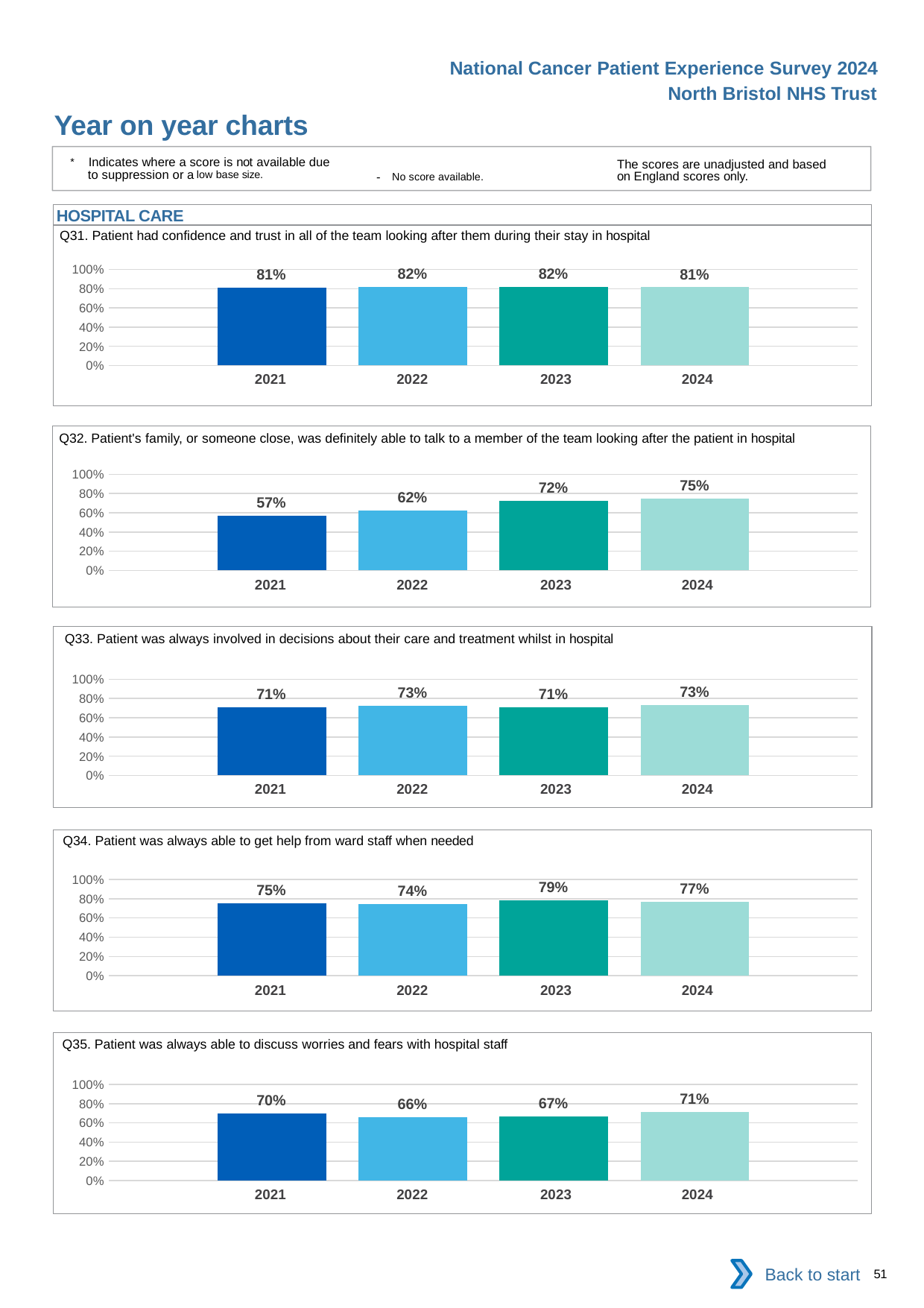
In the Q32 chart (patient's family was definitely able to talk to a member of the team), what is the difference between the 2024 and 2021 values? 18 percentage points In the Q34 chart (patient was always able to get help from ward staff), which is larger, the 2021 value or the 2022 value? 2021 In the Q35 chart (patient was always able to discuss worries and fears), what is the value for 2022? 66% In the Q32 chart (patient's family was definitely able to talk to a member of the team), do the values rise or fall from 2021 to 2024? rise In the Q34 chart (patient was always able to get help from ward staff), which year has the highest value? 2023 In the Q31 chart (patient had confidence and trust in all of the team), what is the value for 2022? 82% In the Q32 chart (patient's family was definitely able to talk to a member of the team), which year has the lowest value? 2021 In the Q35 chart (patient was always able to discuss worries and fears), what is the difference between the 2024 and 2023 values? 4 percentage points In the Q33 chart (patient was always involved in decisions about their care), what is the value for 2023? 71% How many years are shown on the x axis of the Q31 chart? 4 How many charts are shown on the slide? 5 What kind of chart is used for Q33 (patient was always involved in decisions about their care)? bar chart